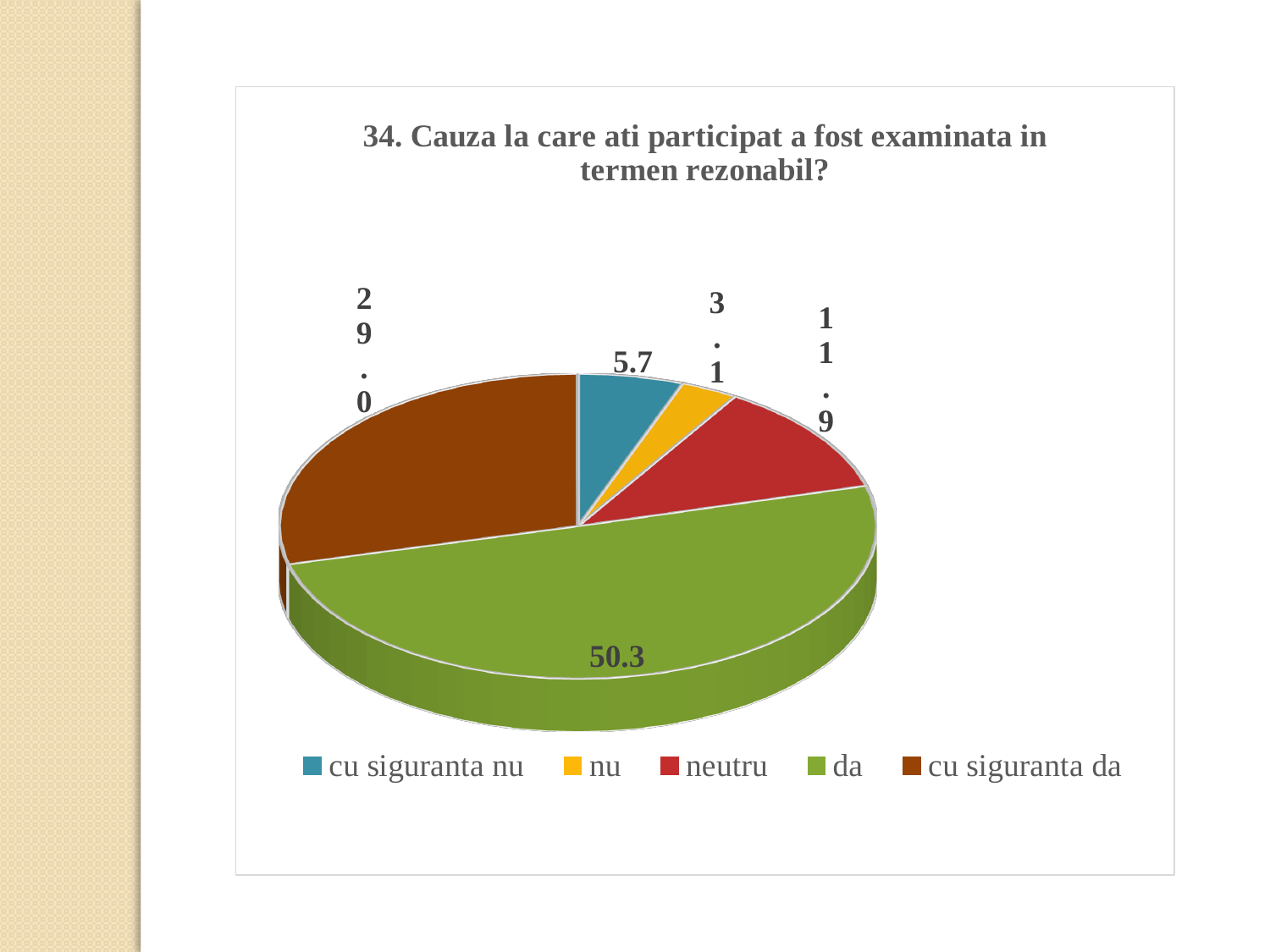
Which category has the smallest slice? nu How many categories does the pie chart have? 5 What is the value for "neutru"? 11.9 What is the title of the chart? 34. Cauza la care ati participat a fost examinata in termen rezonabil? What is the value for "cu siguranta nu"? 5.7 What is the value for "nu"? 3.1 What is the value for "da"? 50.3 What is the value for "cu siguranta da"? 29.0 Which category has the largest slice? da What kind of chart is shown on the slide? pie chart Which is larger, the value for "neutru" or the value for "cu siguranta nu"? neutru What is the difference between the values for "da" and "cu siguranta da"? 21.3